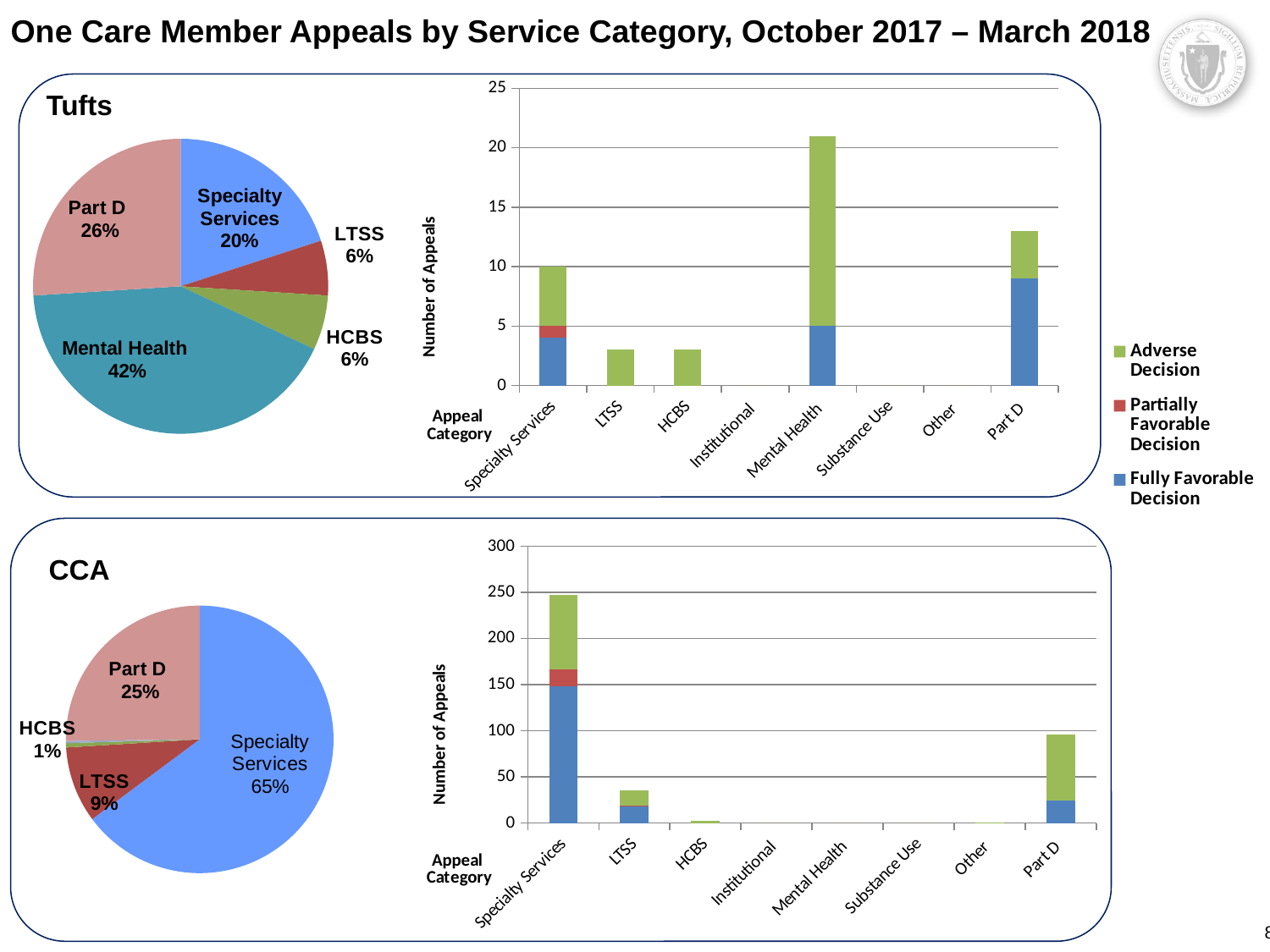
In the CCA pie chart, which service category has the smallest share? HCBS In the Tufts pie chart, what share of appeals is Mental Health? 42% In the CCA pie chart, what share of appeals is Specialty Services? 65% How many series does the legend of the Tufts bar chart list? 3 In the Tufts bar chart, is the total number of appeals for Mental Health greater or less than 20? greater In the CCA bar chart, which category has the highest total number of appeals? Specialty Services In the CCA pie chart, how many slices are there? 4 In the Tufts bar chart, is the total number of appeals for LTSS greater or less than 5? less In the Tufts pie chart, what is the difference in percentage points between Part D and Specialty Services? 6 In the Tufts pie chart, which service category has the largest share? Mental Health In the CCA bar chart, is the total number of appeals for Specialty Services greater or less than 200? greater In the CCA pie chart, which is larger, Part D or LTSS? Part D